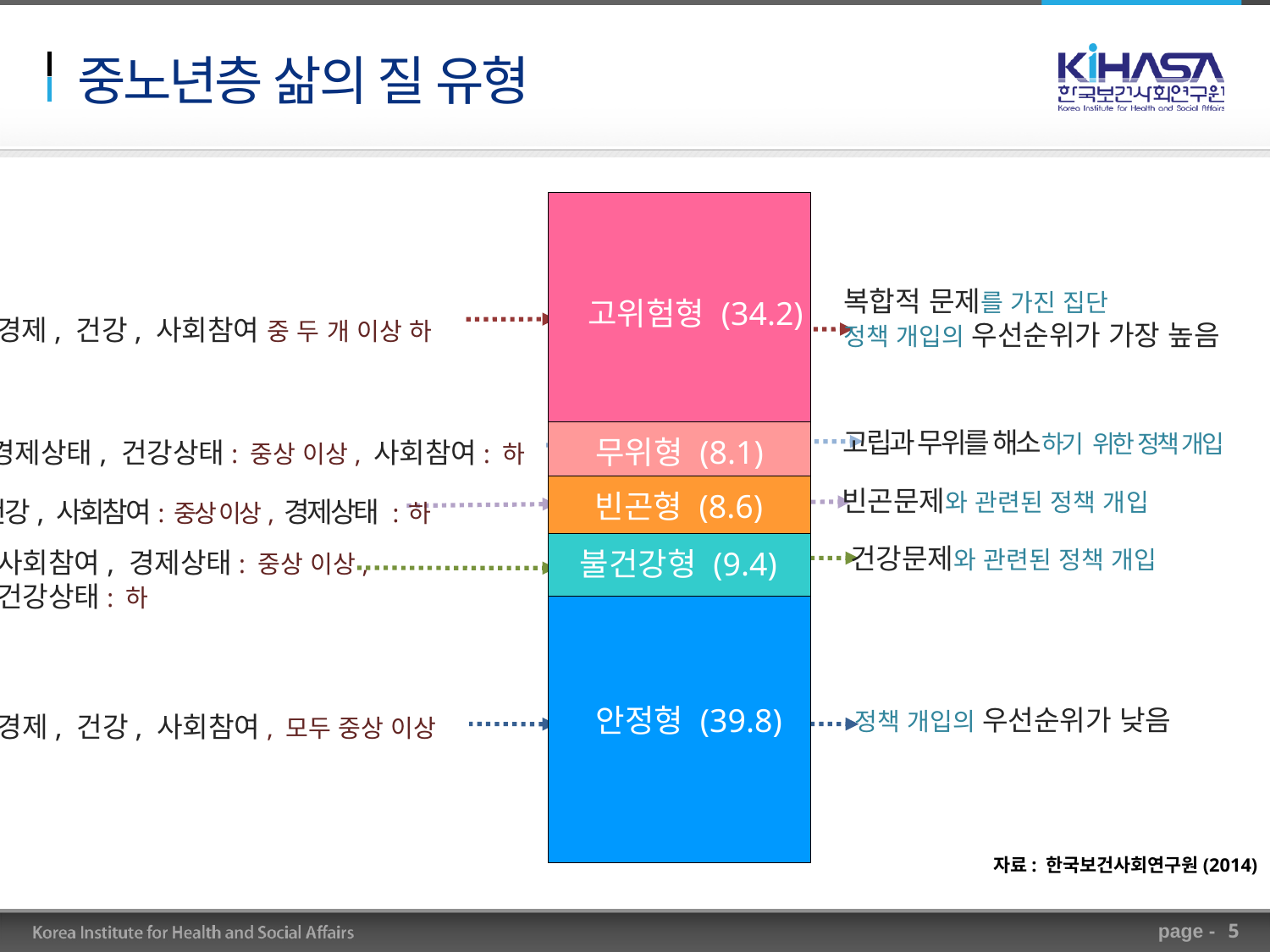
How many segments make up the stacked bar? 5 What value is shown for the 불건강형 segment? 9.4 What value is shown for the 무위형 segment? 8.1 What is the difference between the 안정형 value and the 고위험형 value? 5.6 What value is shown for the 빈곤형 segment? 8.6 Which segment of the stacked bar has the largest value? 안정형 Which segment of the stacked bar has the smallest value? 무위형 What colour is the 안정형 segment at the bottom of the stacked bar? Blue What value is shown for the 안정형 segment of the stacked bar? 39.8 What value is shown for the 고위험형 segment of the stacked bar? 34.2 What is the total of all five segment values in the stacked bar? 100.1 Which is larger, the value for 빈곤형 or the value for 불건강형? 불건강형